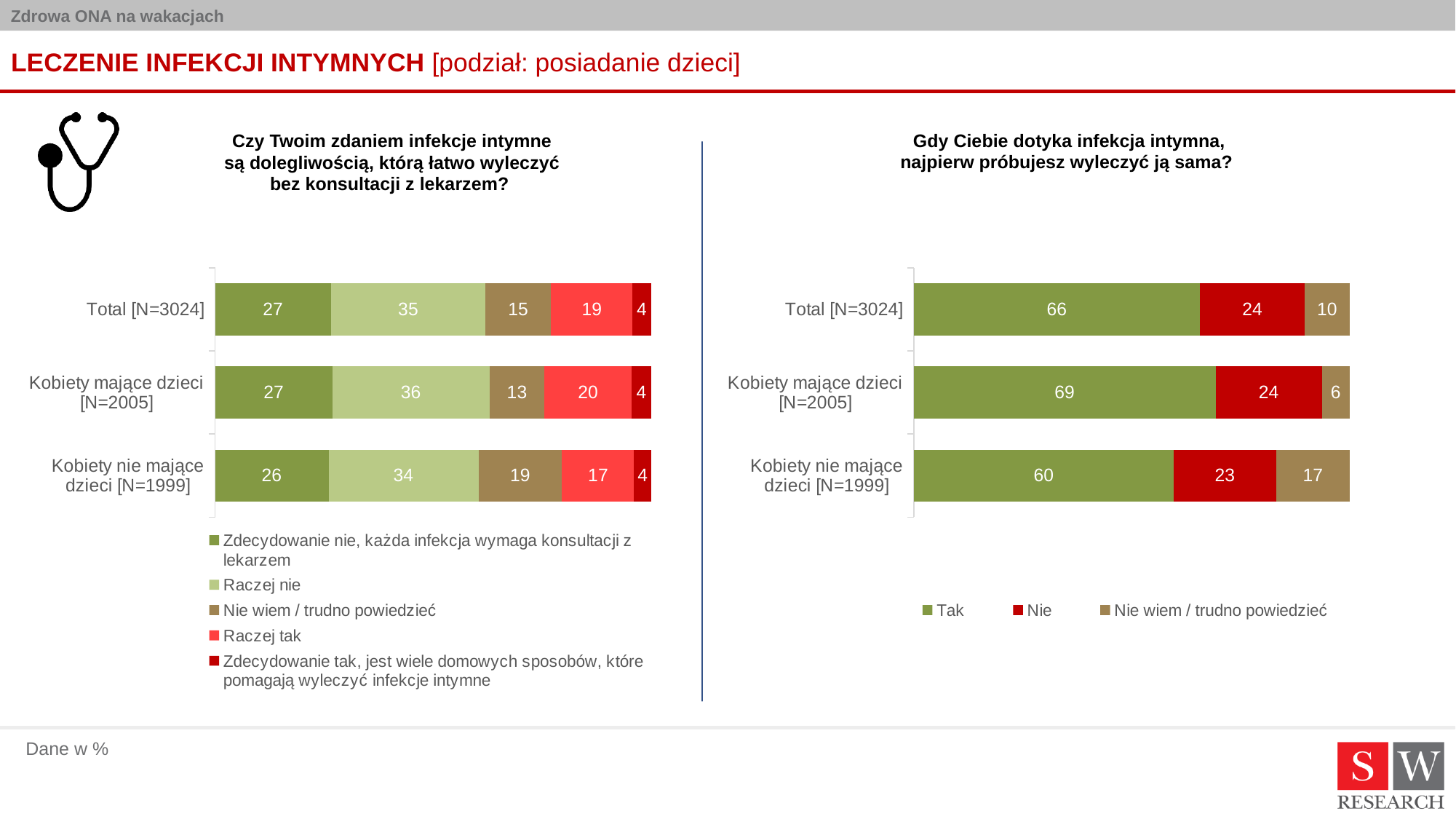
In the right chart, what is the value of "Nie wiem / trudno powiedzieć" for Kobiety nie mające dzieci [N=1999]? 17 How many categories are shown in the right chart? 3 What kind of chart is the right chart? Stacked bar chart In the right chart, which category has the highest value for "Tak"? Kobiety mające dzieci [N=2005] In the left chart, which is larger: "Raczej tak" for Kobiety mające dzieci [N=2005] or "Raczej tak" for Kobiety nie mające dzieci [N=1999]? Kobiety mające dzieci [N=2005] In the left chart, what is the value of "Raczej tak" for Kobiety mające dzieci [N=2005]? 20 In the right chart, what is the difference between the "Tak" values for Kobiety mające dzieci [N=2005] and Kobiety nie mające dzieci [N=1999]? 9 How many series does the legend of the left chart list? 5 In the left chart, what is the value of "Nie wiem / trudno powiedzieć" for Kobiety nie mające dzieci [N=1999]? 19 In the right chart, which category has the lowest value for "Nie wiem / trudno powiedzieć"? Kobiety mające dzieci [N=2005] In the right chart ("Gdy Ciebie dotyka infekcja intymna, najpierw próbujesz wyleczyć ją sama?"), what is the value of "Tak" for Kobiety mające dzieci [N=2005]? 69 In the left chart ("Czy Twoim zdaniem infekcje intymne są dolegliwością, którą łatwo wyleczyć bez konsultacji z lekarzem?"), what is the value of "Raczej nie" for Total [N=3024]? 35